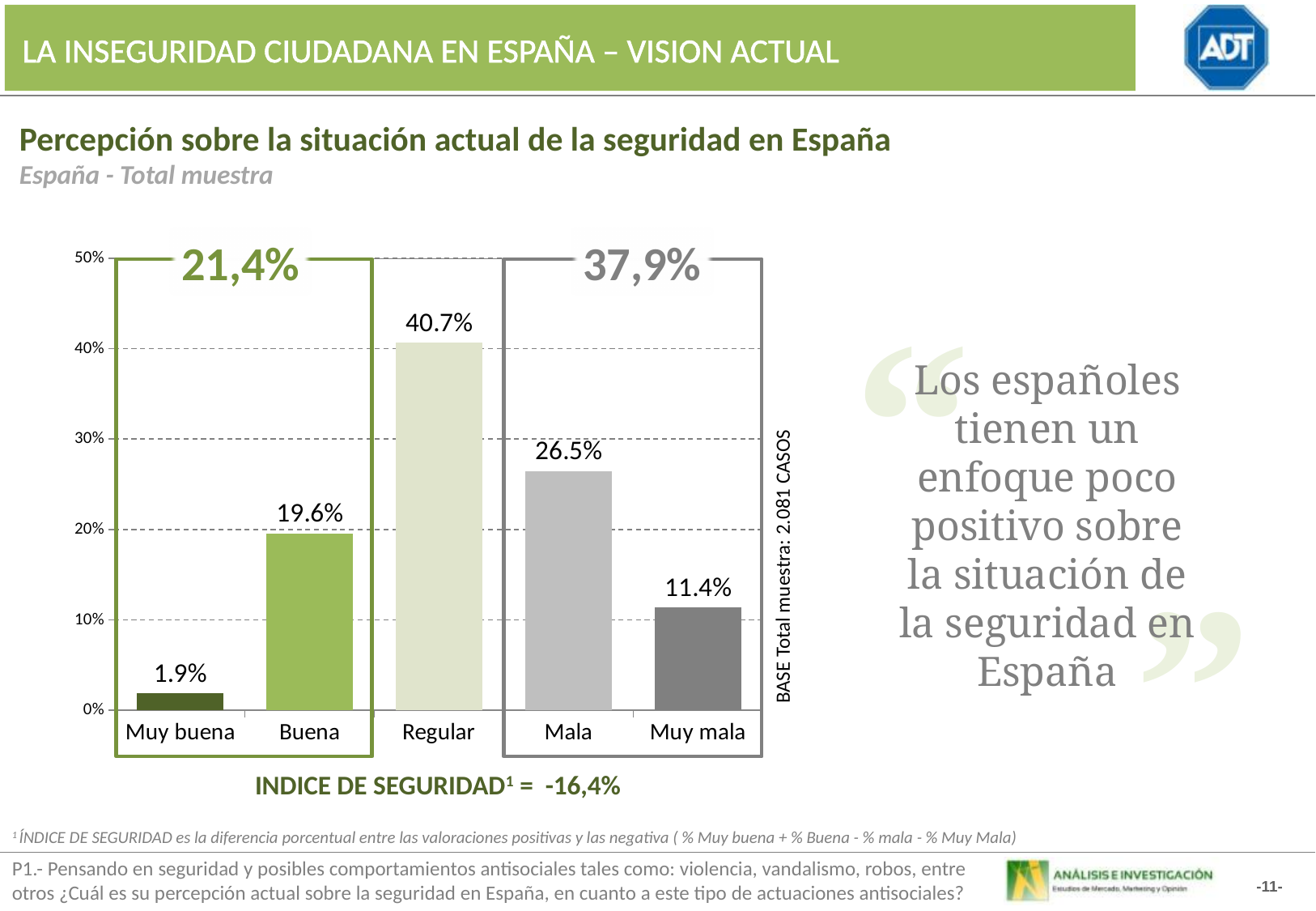
What combined percentage is shown above the Muy buena and Buena bars? 21,4% What is the value for Muy mala? 11.4% Which category has the highest value? Regular How many categories are shown on the x axis? 5 Which category has the lowest value? Muy buena What is the value for Buena? 19.6% What kind of chart is shown on the slide? bar chart What is the value for Regular? 40.7% What is the value of the INDICE DE SEGURIDAD shown below the chart? -16,4% What is the difference between the values for Mala and Muy mala? 15.1% Which is larger, the value for Buena or the value for Mala? Mala Is the value for Regular greater or less than 40%? greater